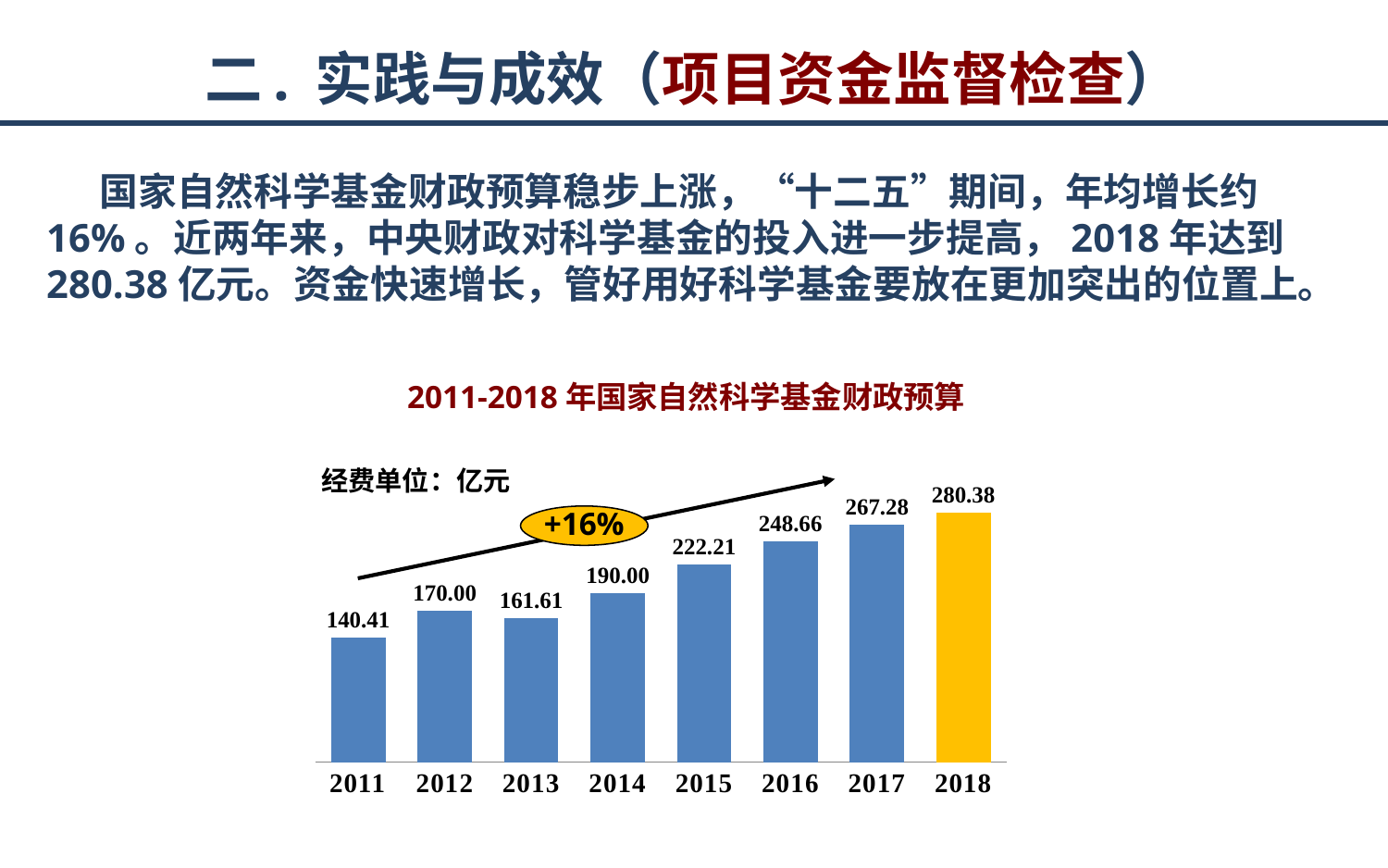
What is the value for 2011? 140.41 Which year has the highest value? 2018 What is the value for 2018? 280.38 What kind of chart is this? bar chart What is the title of the chart? 2011-2018年国家自然科学基金财政预算 Which is larger, the value for 2012 or the value for 2013? 2012 What is the difference between the values for 2018 and 2017? 13.10 How many years are shown on the x axis? 8 Which year has the lowest value? 2011 Do the values generally rise or fall from 2011 to 2018? rise What is the value for 2015? 222.21 What is the difference between the values for 2012 and 2013? 8.39